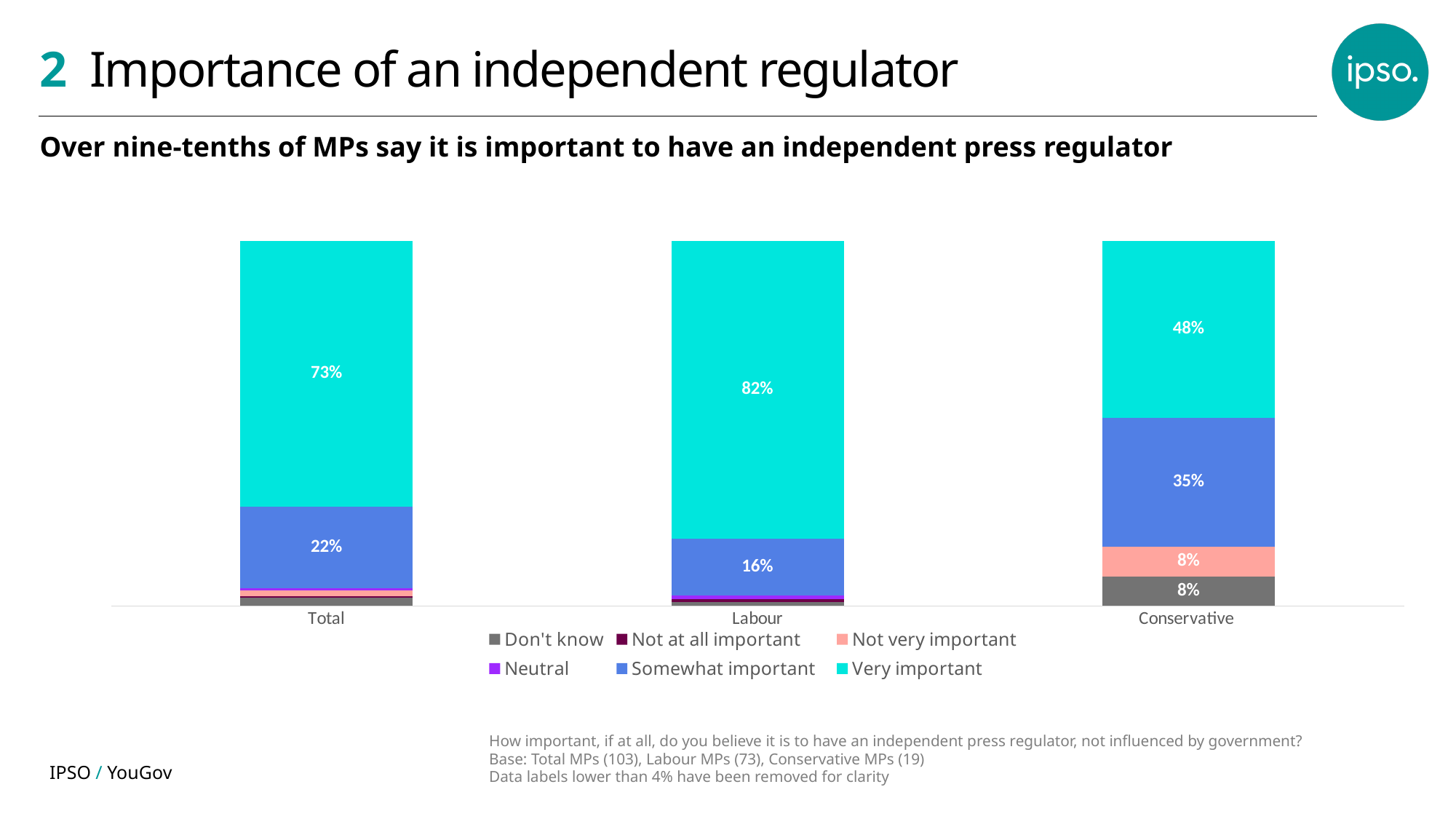
What is the 'Very important' value for the Total bar? 73% How many series does the legend list? 6 Which is larger: the 'Somewhat important' share for Labour or for Conservative? Conservative What is the difference between the 'Somewhat important' shares for Conservative and Total MPs? 13 percentage points What percentage of Conservative MPs say an independent press regulator is somewhat important? 35% How many percentage points higher is the 'Very important' share for Labour than for Total? 9 percentage points Which group has the lowest 'Very important' share? Conservative How many groups (bars) are shown on the x axis? 3 What percentage of Labour MPs say an independent press regulator is very important? 82% What kind of chart is shown on the slide? Stacked bar chart What percentage of Conservative MPs answered 'Don't know'? 8% Which group has the highest 'Very important' share? Labour